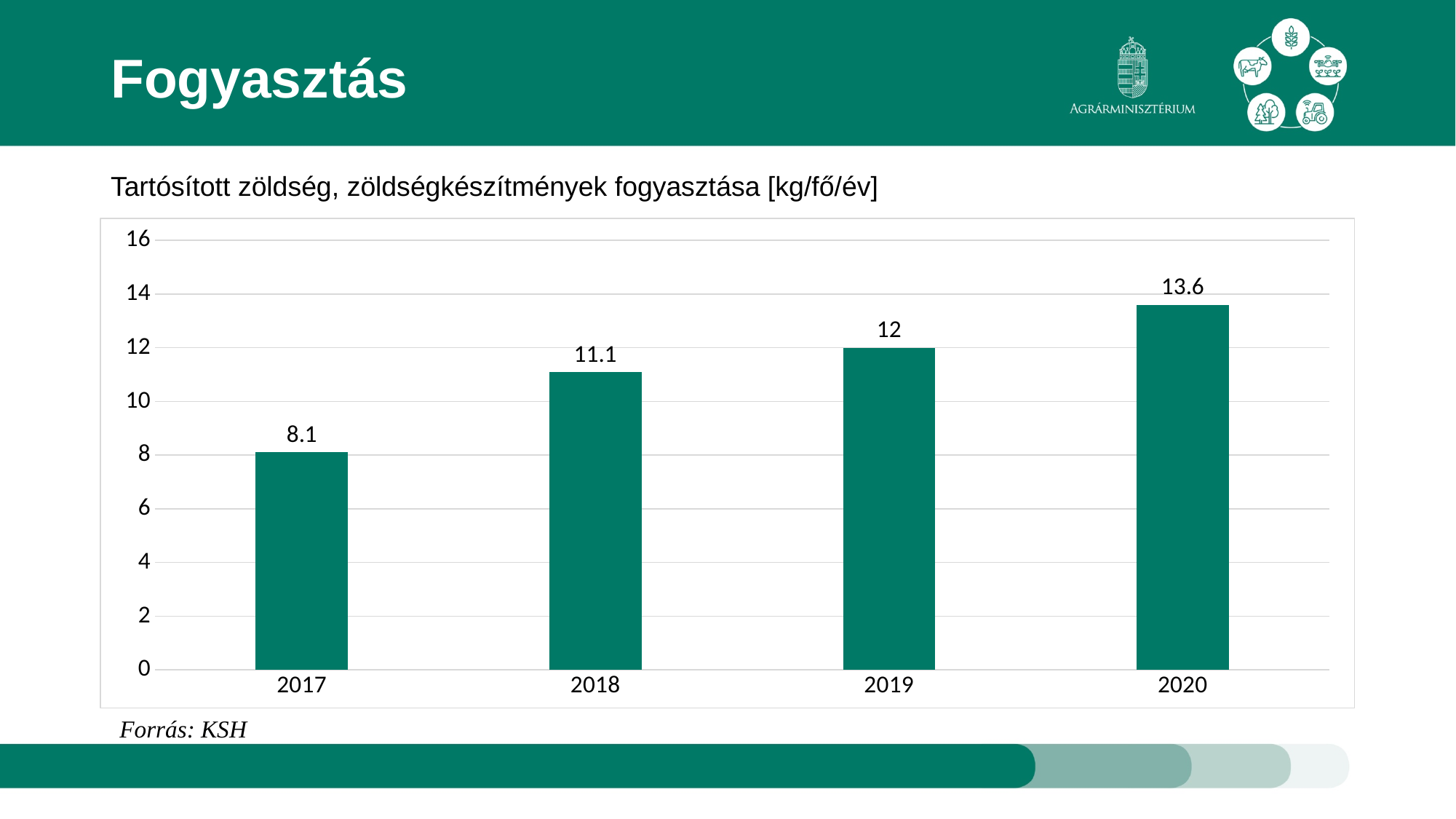
What is the value for 2018? 11.1 What is the difference between the values for 2018 and 2017? 3 What kind of chart is this? bar chart What is the value for 2017? 8.1 What is the value for 2020? 13.6 What is the difference between the values for 2020 and 2017? 5.5 Do the values rise or fall from 2017 to 2020? rise What is the value for 2019? 12 Which year has the highest value? 2020 How many years are shown on the x axis? 4 Which is larger, the value for 2019 or the value for 2018? 2019 Which year has the lowest value? 2017